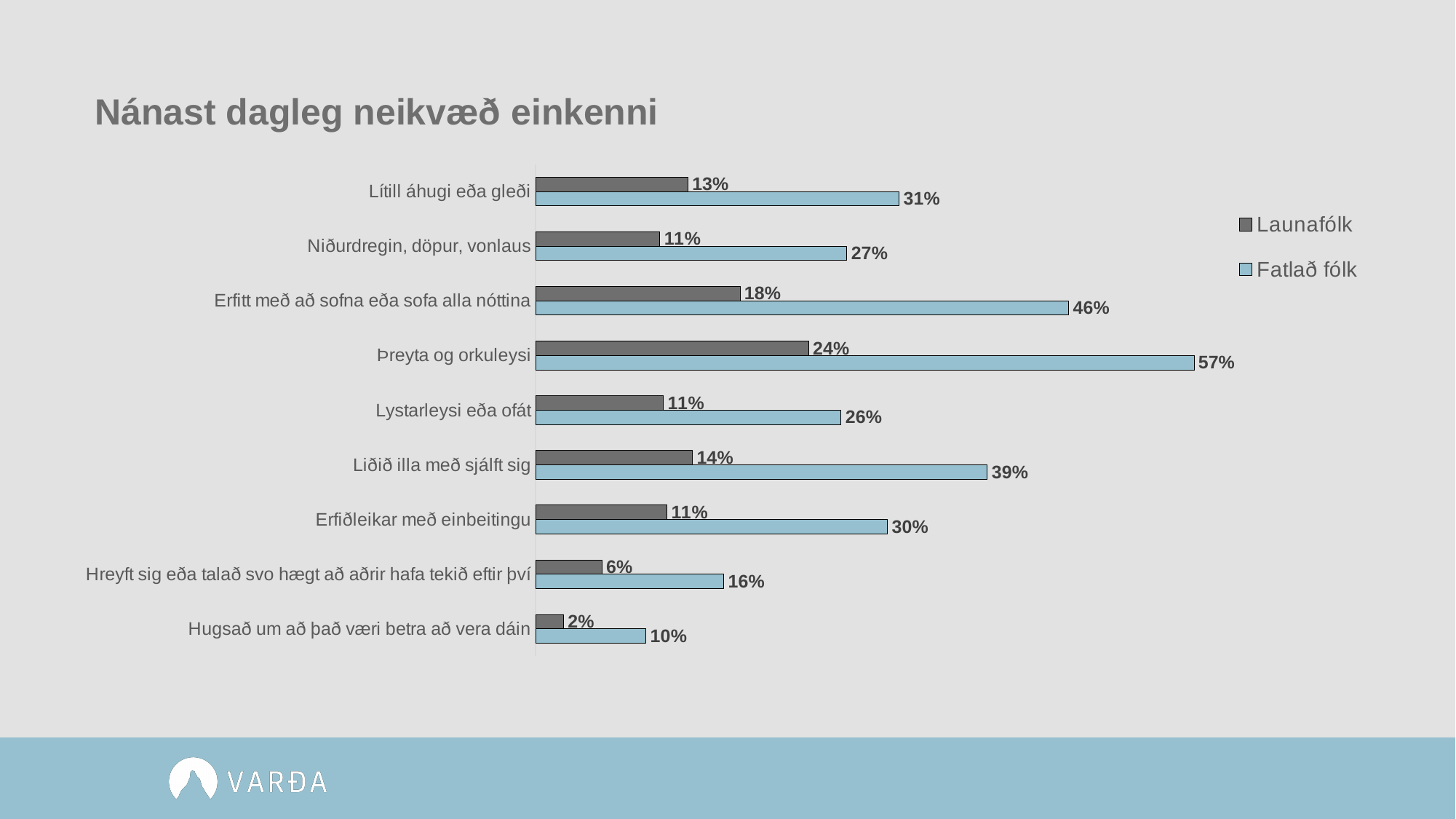
What is the difference between Fatlað fólk and Launafólk for 'Liðið illa með sjálft sig'? 25% Which is larger for 'Lítill áhugi eða gleði': the value for Launafólk or for Fatlað fólk? Fatlað fólk How many categories are shown in the chart? 9 What is the value for Fatlað fólk for 'Hugsað um að það væri betra að vera dáin'? 10% What is the value for Fatlað fólk for 'Þreyta og orkuleysi'? 57% What is the title of the chart? Nánast dagleg neikvæð einkenni Which category has the lowest value for Launafólk? Hugsað um að það væri betra að vera dáin Which series is shown in light blue? Fatlað fólk Which category has the highest value for Fatlað fólk? Þreyta og orkuleysi What kind of chart is shown on the slide? Bar chart What is the value for Launafólk for 'Erfitt með að sofna eða sofa alla nóttina'? 18% How many series does the legend list? 2